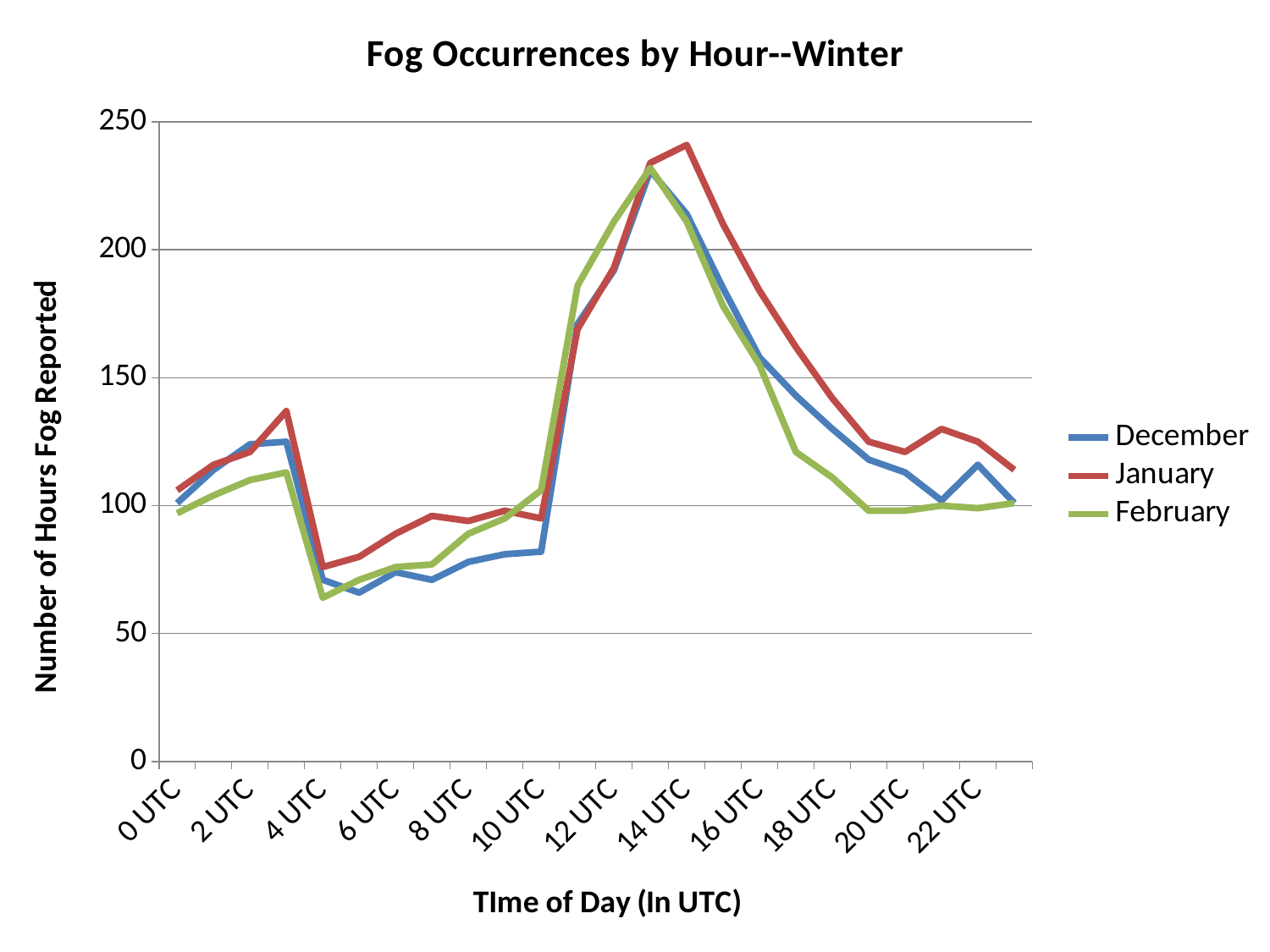
Is the value for December at 6 UTC greater or less than 100? less At 18 UTC, which series has the larger value, January or February? January What kind of chart is shown on the slide? line chart Which series has the lowest value at 4 UTC? February What is the label of the y axis? Number of Hours Fog Reported How many series does the legend list? 3 How many hour labels are shown along the x axis? 12 Is the value for February at 4 UTC greater or less than 100? less What is the title of the chart? Fog Occurrences by Hour--Winter Is the value for January at 14 UTC greater or less than 200? greater Which series reaches the highest peak value on the chart? January Do the values for all three series rise or fall between 14 UTC and 18 UTC? fall